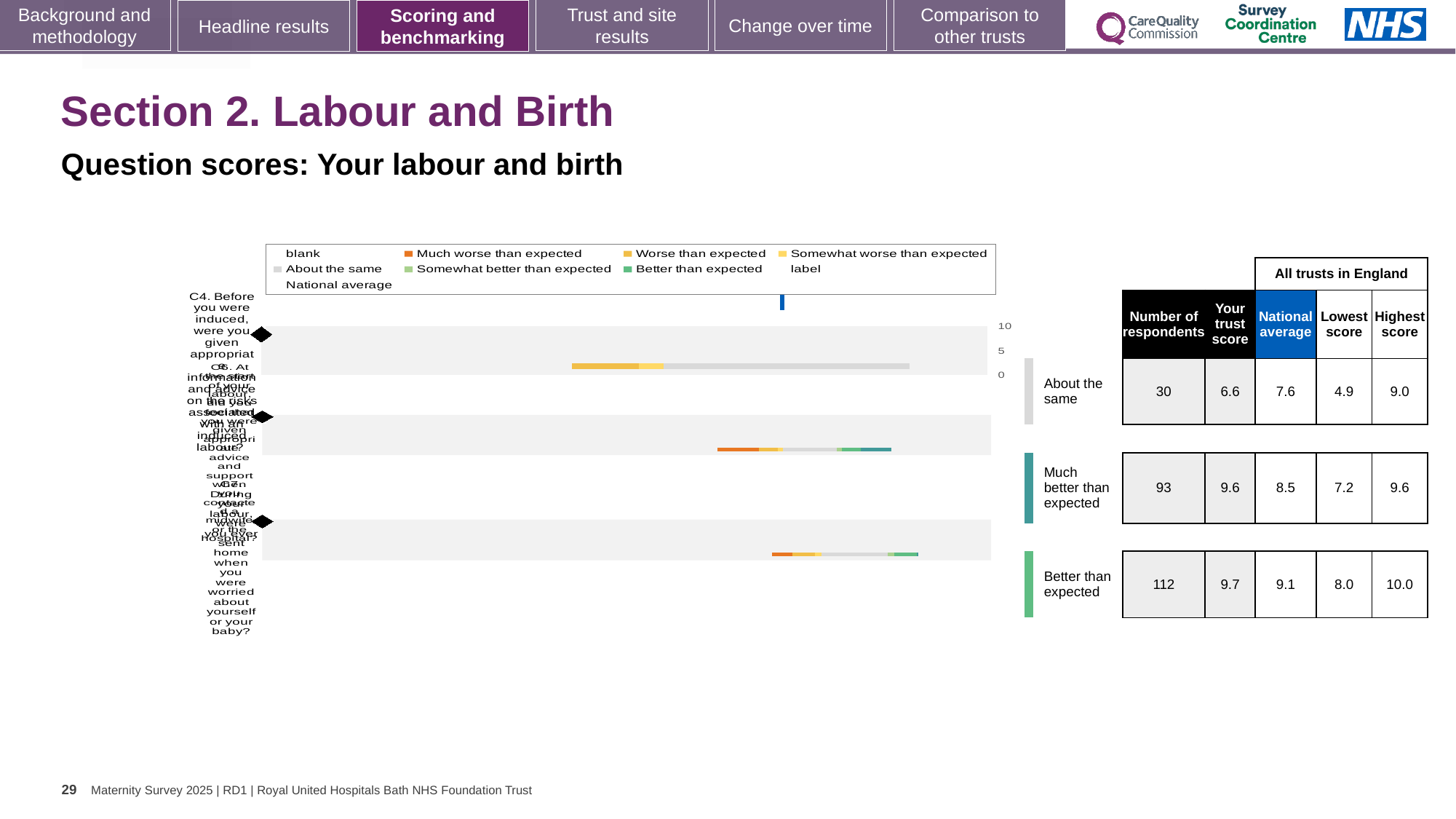
What kind of chart is shown on the slide? bar chart In the table beside the chart, what is the difference between the highest score and the lowest score for the row labelled 'About the same'? 4.1 In the table beside the chart, which row has the highest number of respondents? Better than expected How many horizontal bars (questions) are plotted in the chart? 3 In the table beside the chart, what is the number of respondents for the row labelled 'Better than expected'? 112 In the chart legend, what colour represents 'Much worse than expected'? orange In the chart legend, what colour represents 'Better than expected'? teal green In the table beside the chart, what is the highest score for the row labelled 'Better than expected'? 10.0 In the table beside the chart, for the row labelled 'About the same', which is larger: the trust score or the national average? national average In the table beside the chart, what is the 'Your trust score' value for the row labelled 'Much better than expected'? 9.6 In the table beside the chart, what is the national average for the row labelled 'About the same'? 7.6 In the table beside the chart, which row has the lowest 'Your trust score'? About the same